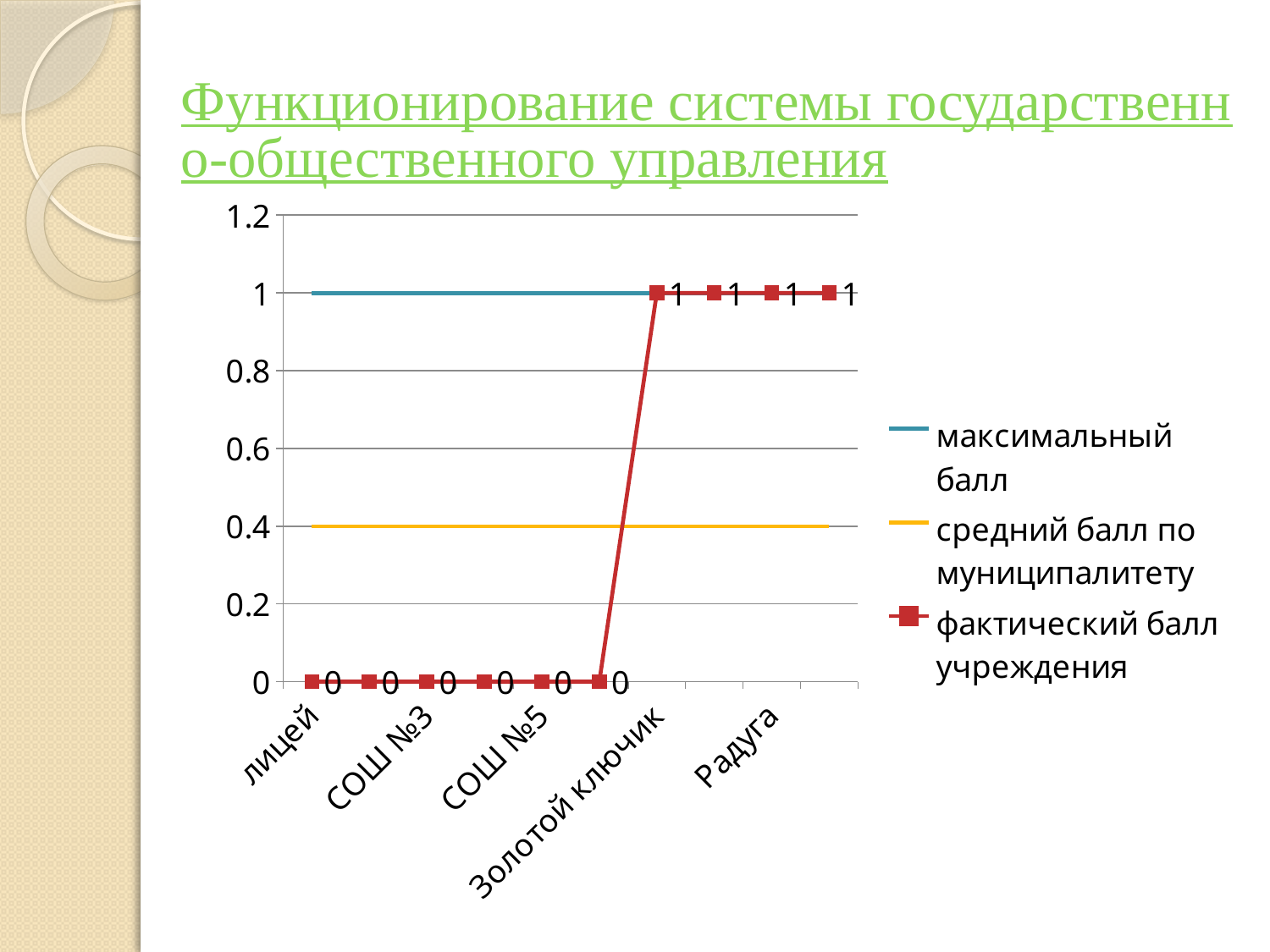
What is the фактический балл учреждения for Радуга? 1 What is the фактический балл учреждения for СОШ №3? 0 What kind of chart is shown on the slide? line chart How many data points are plotted for the фактический балл учреждения series? 10 Which has the higher фактический балл учреждения, СОШ №5 or Золотой ключик? Золотой ключик At what value does the максимальный балл line run? 1 What is the фактический балл учреждения for Золотой ключик? 1 At what value does the средний балл по муниципалитету line run? 0.4 Does the фактический балл учреждения rise or fall moving from лицей to Радуга along the x axis? rises How many series does the legend list? 3 What is the фактический балл учреждения for лицей? 0 What is the difference between the фактический балл учреждения for Золотой ключик and for лицей? 1